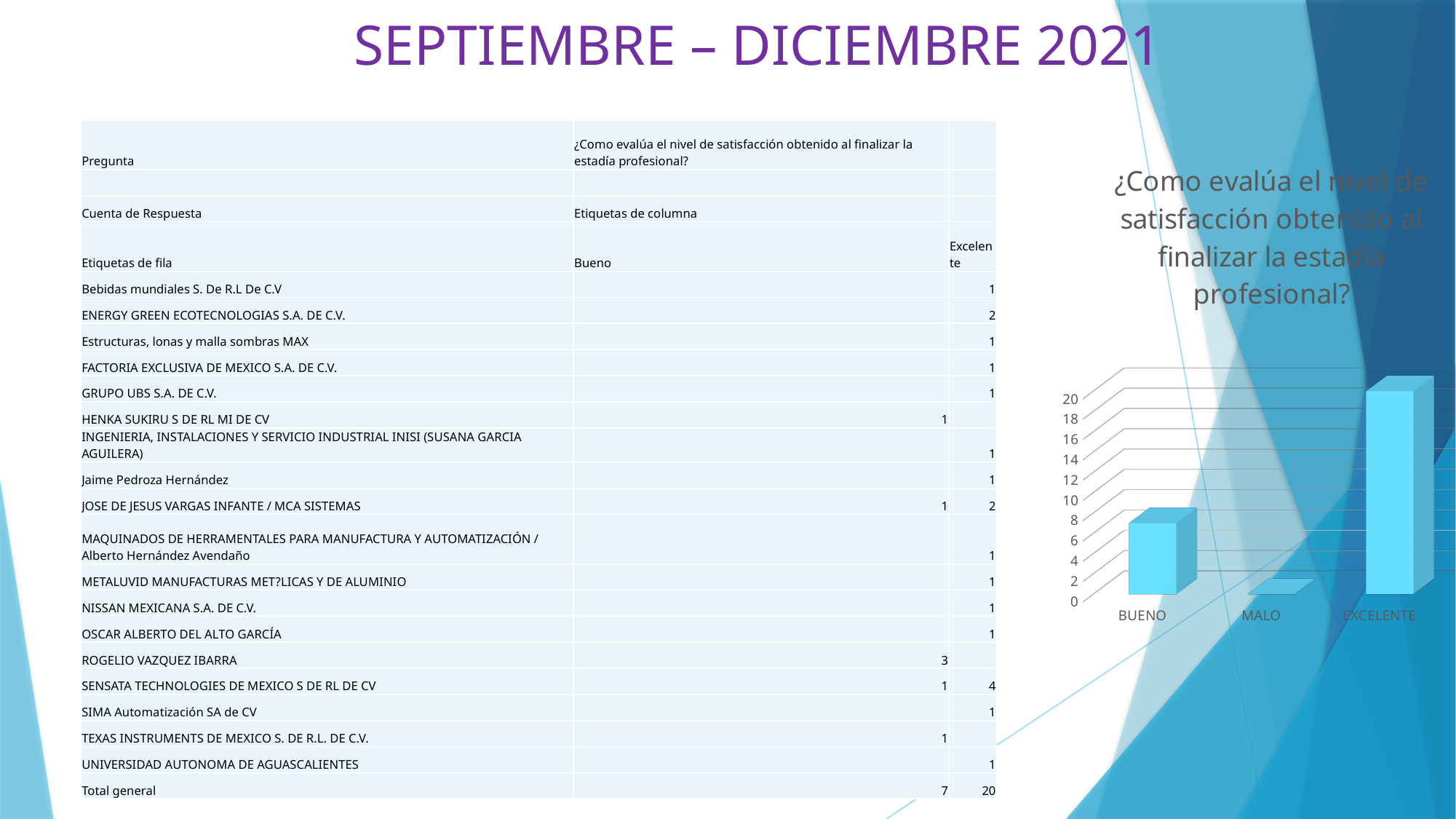
Is the value for MALO greater or less than 2? less What is the highest tick value shown on the chart's vertical axis? 20 What is the title of the chart? ¿Como evalúa el nivel de satisfacción obtenido al finalizar la estadía profesional? Which is larger in the chart, the value for BUENO or the value for EXCELENTE? EXCELENTE Is the value for EXCELENTE greater or less than 16? greater What kind of chart is shown on the slide? bar chart Which category has the lowest bar in the chart? MALO Is the value for BUENO greater or less than 10? less Which category has the highest bar in the chart? EXCELENTE How many categories are shown on the x axis of the chart? 3